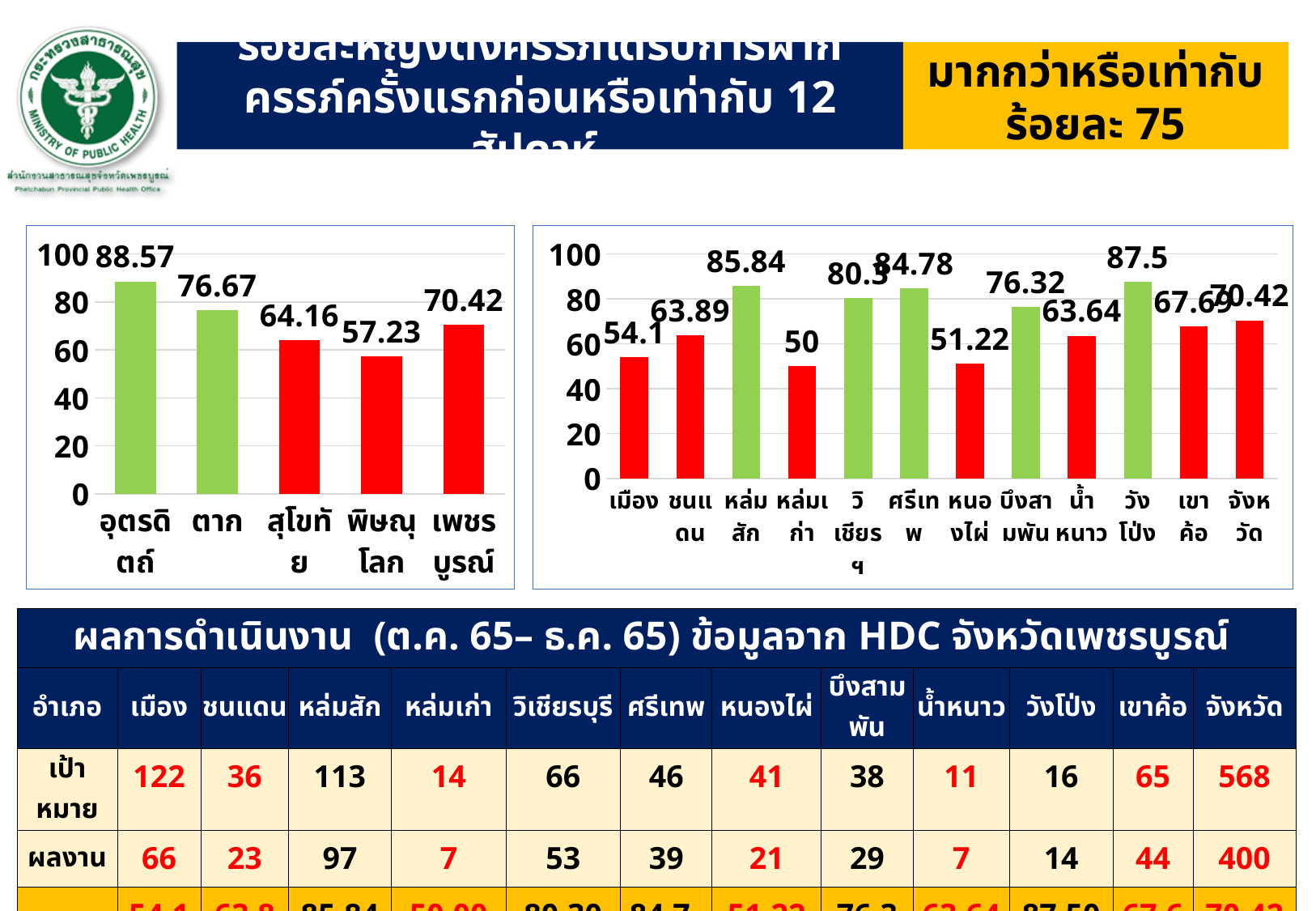
In the left chart, which category has the highest value? อุตรดิตถ์ In the left chart, what is the value for อุตรดิตถ์? 88.57 In the right chart, which is larger, the value for ชนแดน or the value for บึงสามพัน? บึงสามพัน What kind of chart is the right chart? bar chart In the left chart, how many bars are there? 5 In the right chart, what is the value for หล่มเก่า? 50 In the right chart, which category has the lowest value? หล่มเก่า In the right chart, which category has the highest value? วังโป่ง In the left chart, which category has the lowest value? พิษณุโลก In the right chart, what is the value for หล่มสัก? 85.84 In the left chart, what is the value for พิษณุโลก? 57.23 In the left chart, what is the difference between the values for ตาก and สุโขทัย? 12.51